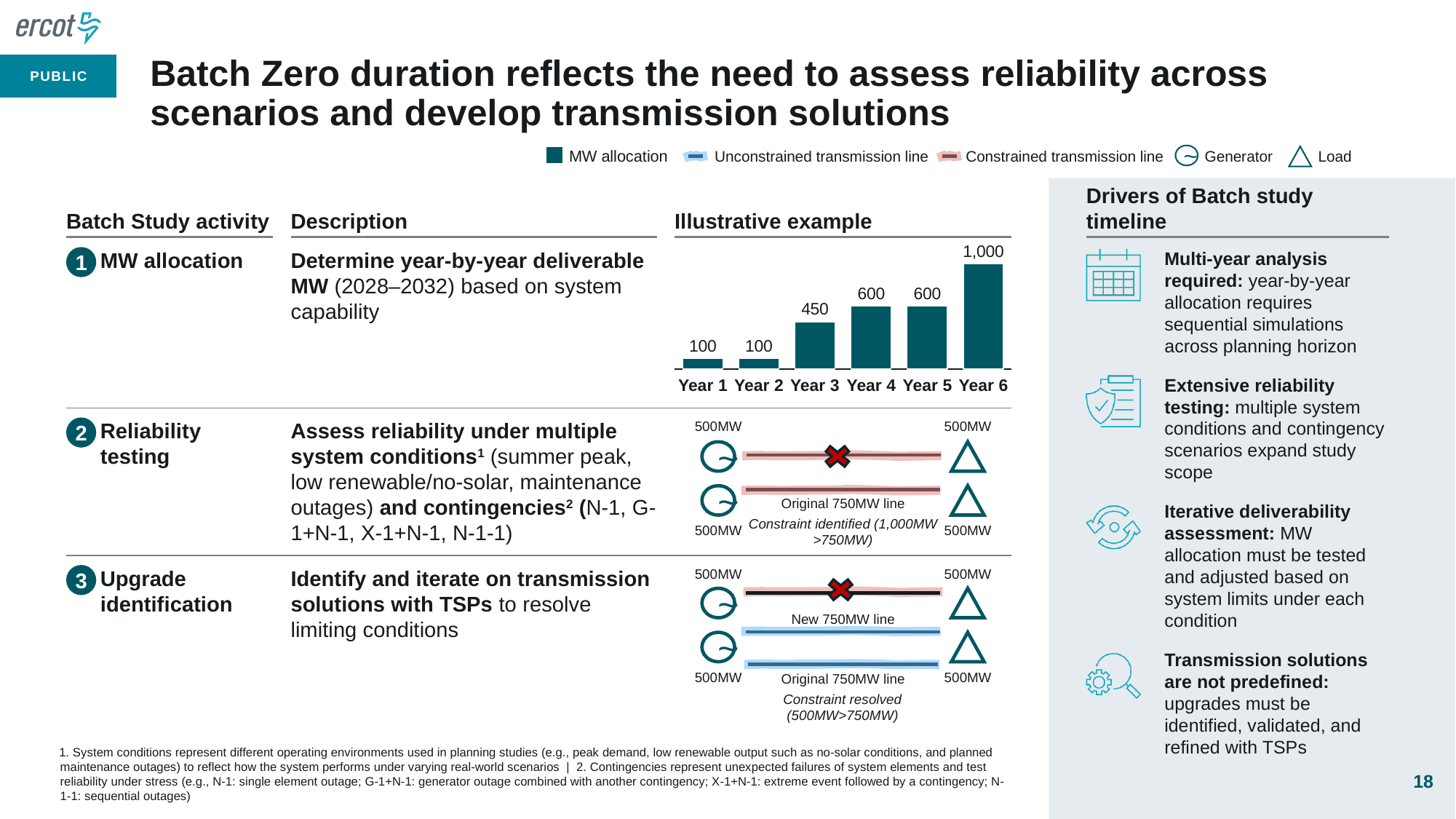
What kind of chart is used for the MW allocation illustrative example? Bar chart In the MW allocation bar chart, what is the value for Year 1? 100 In the MW allocation bar chart, what is the difference between the values for Year 3 and Year 2? 350 In the MW allocation bar chart, do the values generally rise or fall from Year 1 to Year 6? Rise In the MW allocation bar chart, what is the value for Year 6? 1,000 In the MW allocation bar chart, what is the value for Year 3? 450 In the MW allocation bar chart, which is larger, the value for Year 4 or the value for Year 3? Year 4 In the MW allocation bar chart, which year has the highest value? Year 6 Under which column heading does the MW allocation bar chart appear on the slide? Illustrative example In the MW allocation bar chart, which two years share the value 600? Year 4 and Year 5 How many years (categories) are shown in the MW allocation bar chart? 6 In the MW allocation bar chart, what is the difference between the values for Year 6 and Year 5? 400